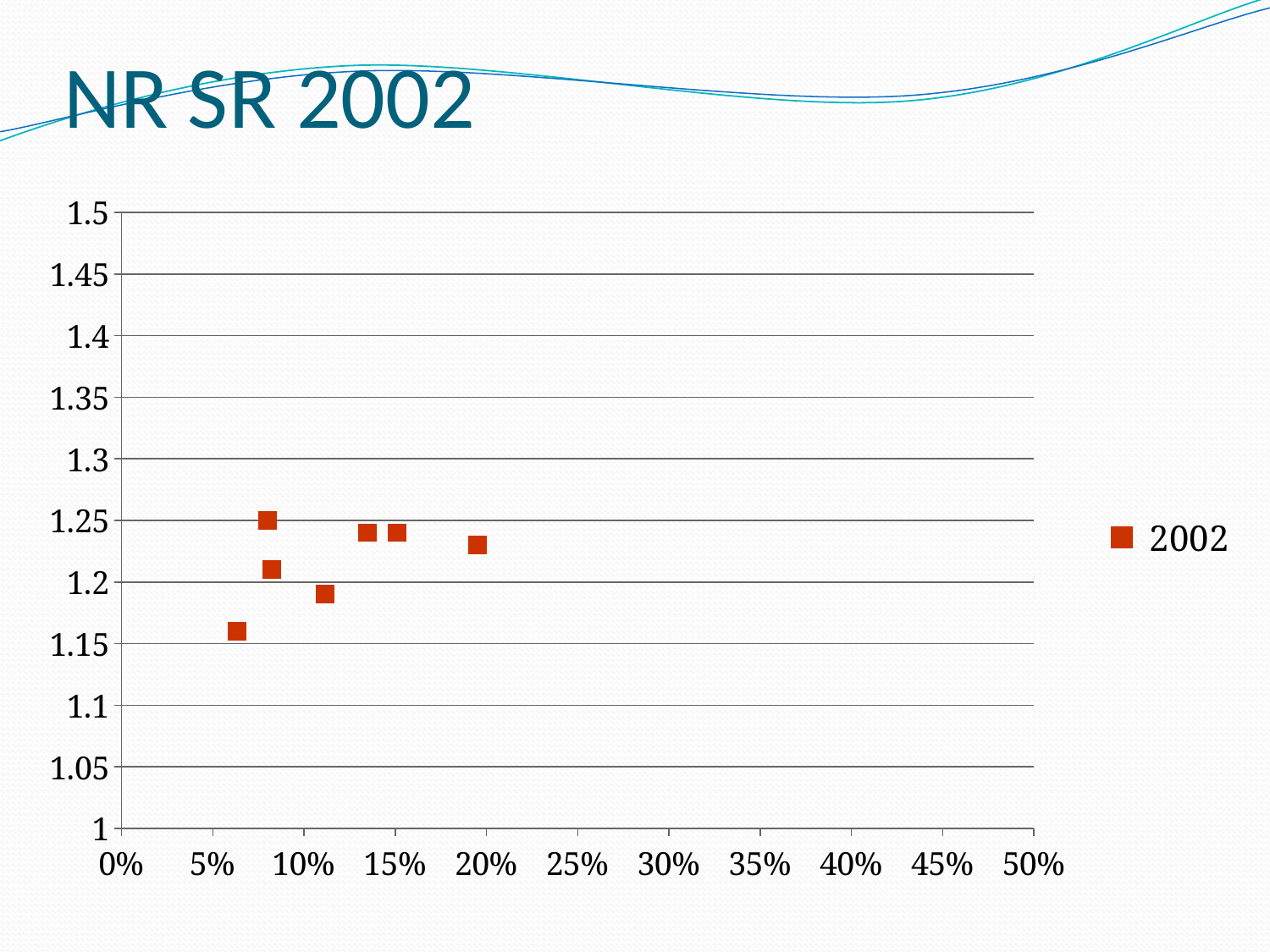
What kind of chart is shown on the slide? scatter chart What is the name of the series shown in the legend? 2002 Are all plotted points located at x values less than 25%? yes What is the title of the slide containing the chart? NR SR 2002 Which has the higher vertical-axis value: the leftmost point (near 6%) or the rightmost point (near 20%)? the rightmost point (near 20%) How many data points are plotted on the chart? 7 What is the maximum value shown on the vertical axis? 1.5 Is the value of the rightmost point (near 20% on the x axis) greater or less than 1.2? greater How many series does the legend list? 1 Is the highest plotted point on the chart greater or less than 1.3 on the vertical axis? less